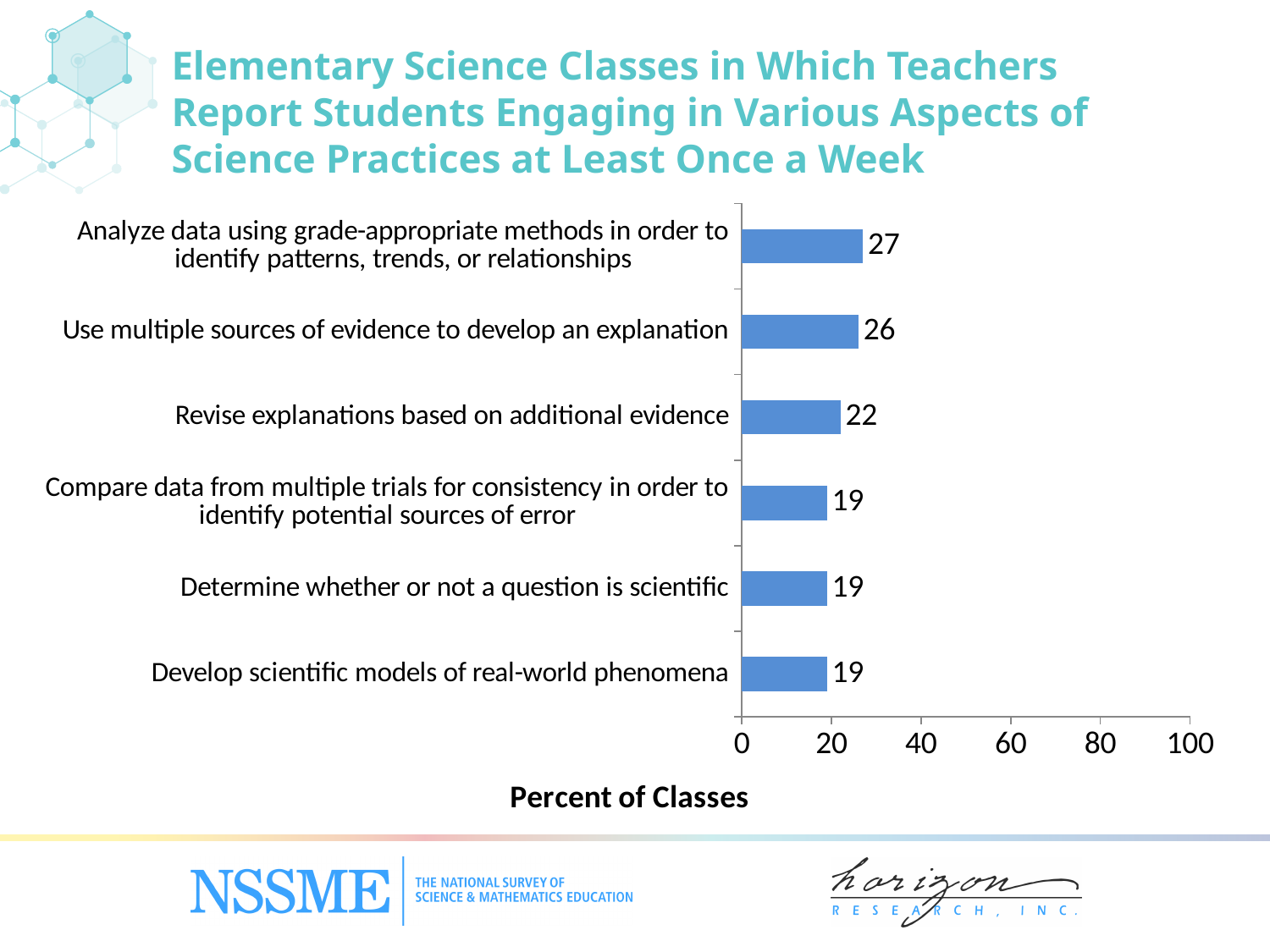
Is the value for "Analyze data using grade-appropriate methods in order to identify patterns, trends, or relationships" greater or less than 40? less How many categories have a value of 19? 3 What is the value for "Develop scientific models of real-world phenomena"? 19 Which category has the highest percent of classes? Analyze data using grade-appropriate methods in order to identify patterns, trends, or relationships How many categories are shown in the chart? 6 Which is larger: the value for "Use multiple sources of evidence to develop an explanation" or the value for "Determine whether or not a question is scientific"? Use multiple sources of evidence to develop an explanation What is the maximum value shown on the horizontal axis? 100 What percent of classes is reported for "Revise explanations based on additional evidence"? 22 What is the label of the horizontal axis? Percent of Classes What is the difference between the values for "Analyze data using grade-appropriate methods in order to identify patterns, trends, or relationships" and "Revise explanations based on additional evidence"? 5 What is the value for "Use multiple sources of evidence to develop an explanation"? 26 What kind of chart is shown on the slide? Bar chart